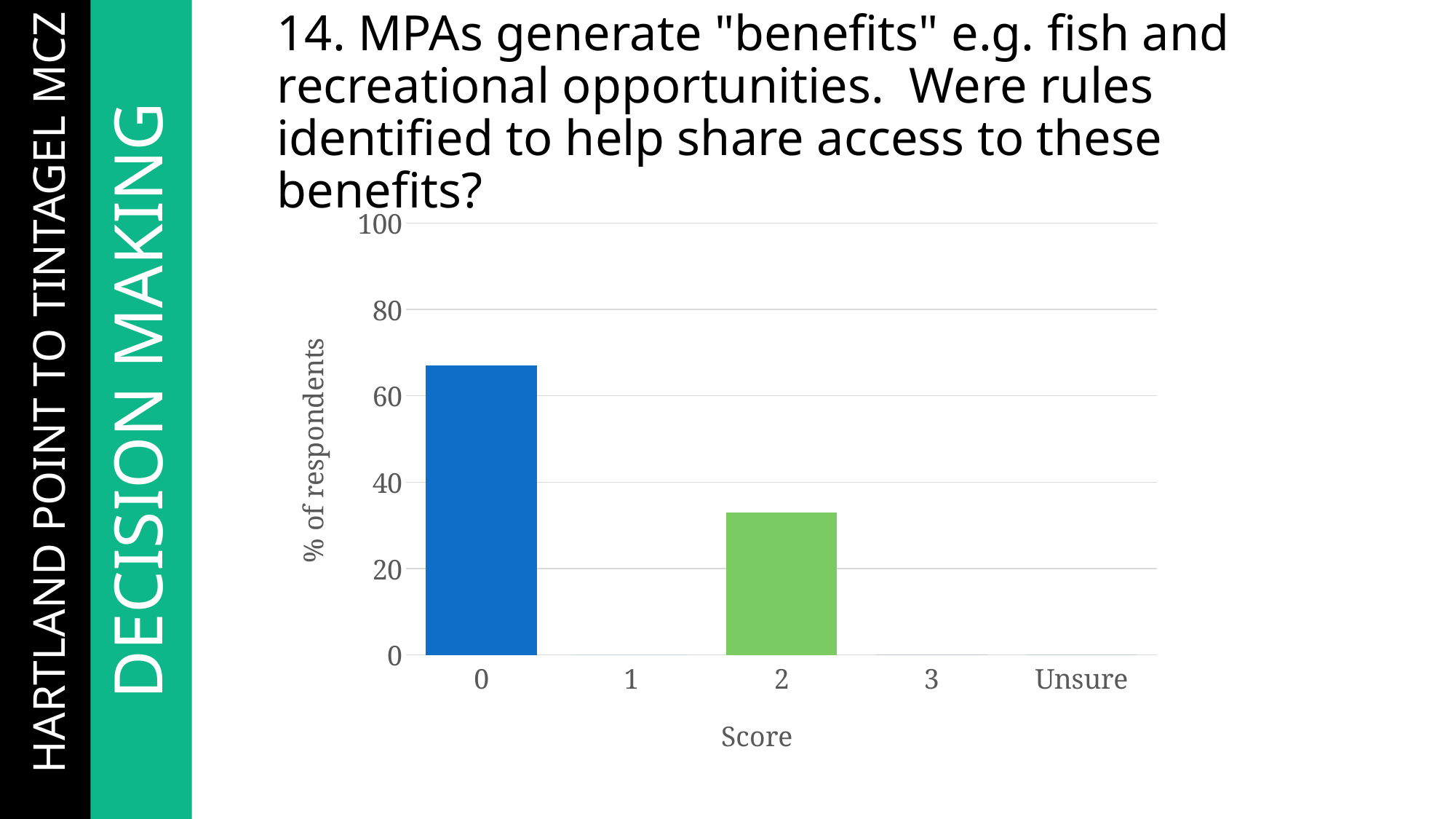
Is the value for score 0 greater or less than 60? greater Is the value for score 0 greater or less than 80? less What kind of chart is shown on the slide? bar chart Which score category has the highest percentage of respondents? 0 How many score categories are shown on the x axis? 5 What is the label of the x axis? Score What is the maximum value shown on the y axis? 100 What is the label of the y axis? % of respondents Which is larger, the value for score 0 or the value for score 2? score 0 Is the value for score 2 greater or less than 20? greater